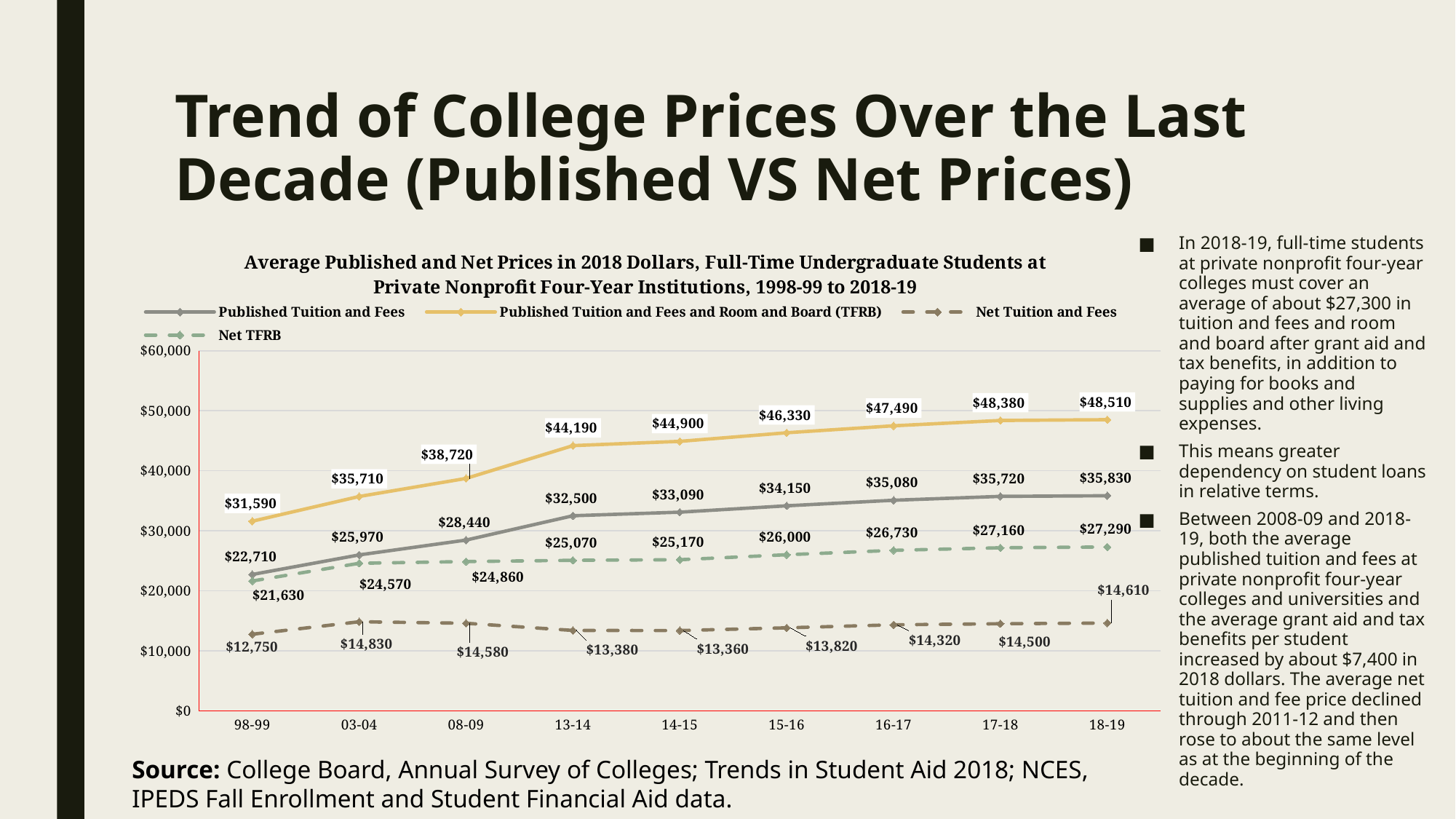
What is the value of Net TFRB in 15-16? $26,000 How many academic years are shown on the x axis? 9 In 08-09, which is larger: Published Tuition and Fees or Net TFRB? Published Tuition and Fees How many series does the legend list? 4 What is the value of Net Tuition and Fees in 98-99? $12,750 What is the difference between Published TFRB and Net TFRB in 18-19? $21,220 In which year is Published Tuition and Fees lowest? 98-99 In which year is Net Tuition and Fees highest? 03-04 By how much did Published Tuition and Fees increase from 08-09 to 18-19? $7,390 What kind of chart is shown on the slide? Line chart Is the value for Published TFRB in 13-14 greater or less than $40,000? greater What is the value of Published Tuition and Fees and Room and Board (TFRB) in 18-19? $48,510